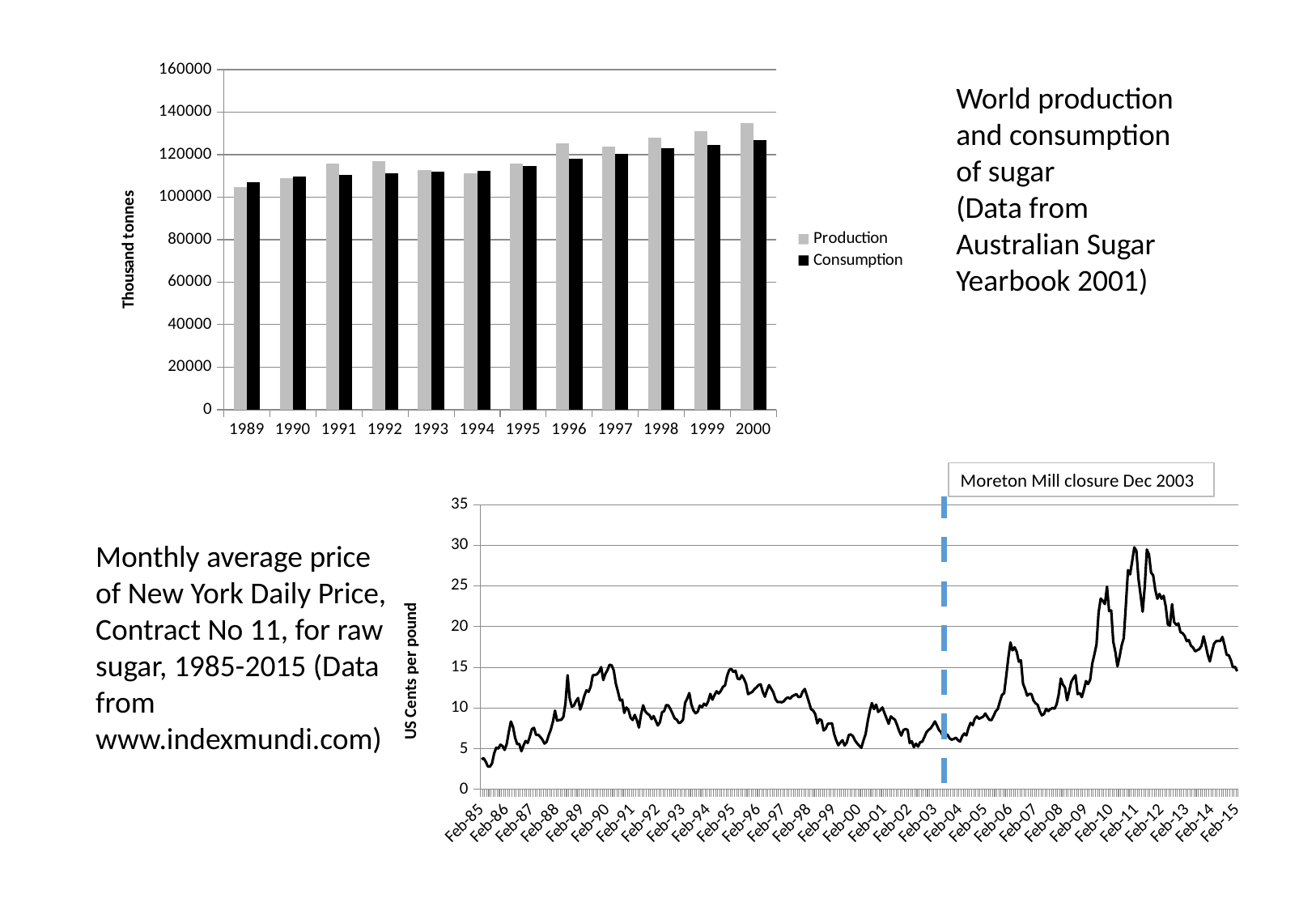
How many series does the legend of the top chart list? 2 In the bottom chart, is the highest peak of the price greater or less than 25? greater In the top chart, do Production values generally rise or fall from 1989 to 2000? rise In the top chart, is the Consumption value for 1994 greater or less than 120000? less In the top chart, which year has the highest Production value? 2000 In the top chart, is the Production value for 2000 greater or less than 120000? greater How many years are shown on the x axis of the top chart? 12 What type of chart is the bottom chart showing the monthly average price of raw sugar? line chart What event does the dashed vertical line in the bottom chart mark? Moreton Mill closure Dec 2003 In the top chart, which is larger in 2000, Production or Consumption? Production In the top chart, which year has the lowest Consumption value? 1989 What type of chart is the top chart showing world production and consumption of sugar? bar chart